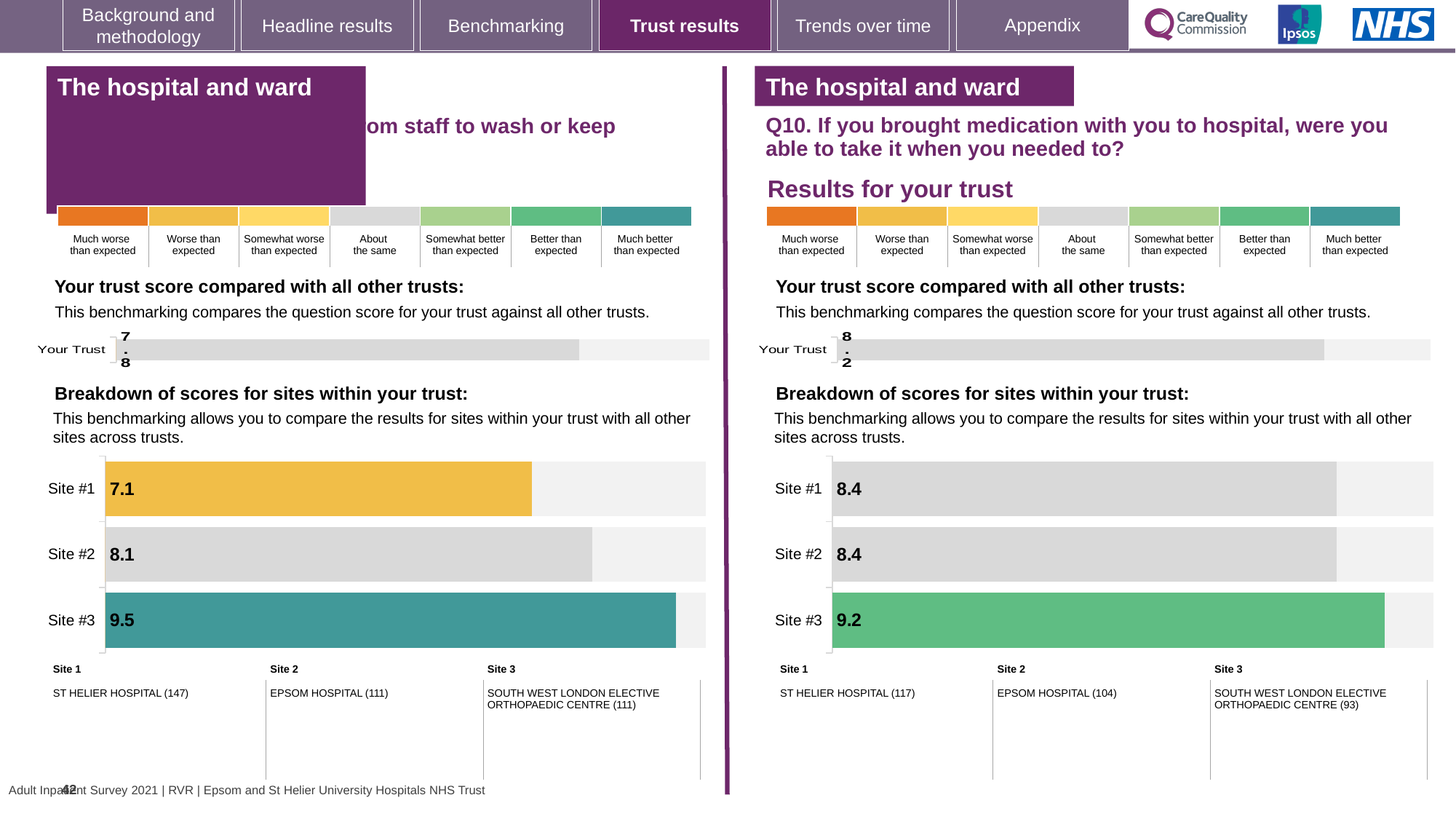
On the right-hand (Q10) 'Your trust score compared with all other trusts' chart, what is the score for Your Trust? 8.2 How many sites are shown in the right-hand (Q10) site breakdown chart? 3 On the right-hand (Q10) site breakdown chart, which site has the highest score? Site #3 On the right-hand (Q10) site breakdown chart, what is the score for Site #3? 9.2 On the left-hand site breakdown chart, which site has the lowest score? Site #1 On the left-hand site breakdown chart, what is the score for Site #1? 7.1 On the left-hand site breakdown chart, which site has the highest score? Site #3 On the right-hand (Q10) site breakdown chart, what is the difference between the scores for Site #3 and Site #2? 0.8 On the left-hand 'Your trust score compared with all other trusts' chart, what is the score for Your Trust? 7.8 On the left-hand site breakdown chart, which is larger: the score for Site #2 or Site #1? Site #2 What type of chart is used for the site breakdown on the right-hand (Q10) side? Bar chart On the left-hand site breakdown chart, what is the difference between the scores for Site #3 and Site #1? 2.4